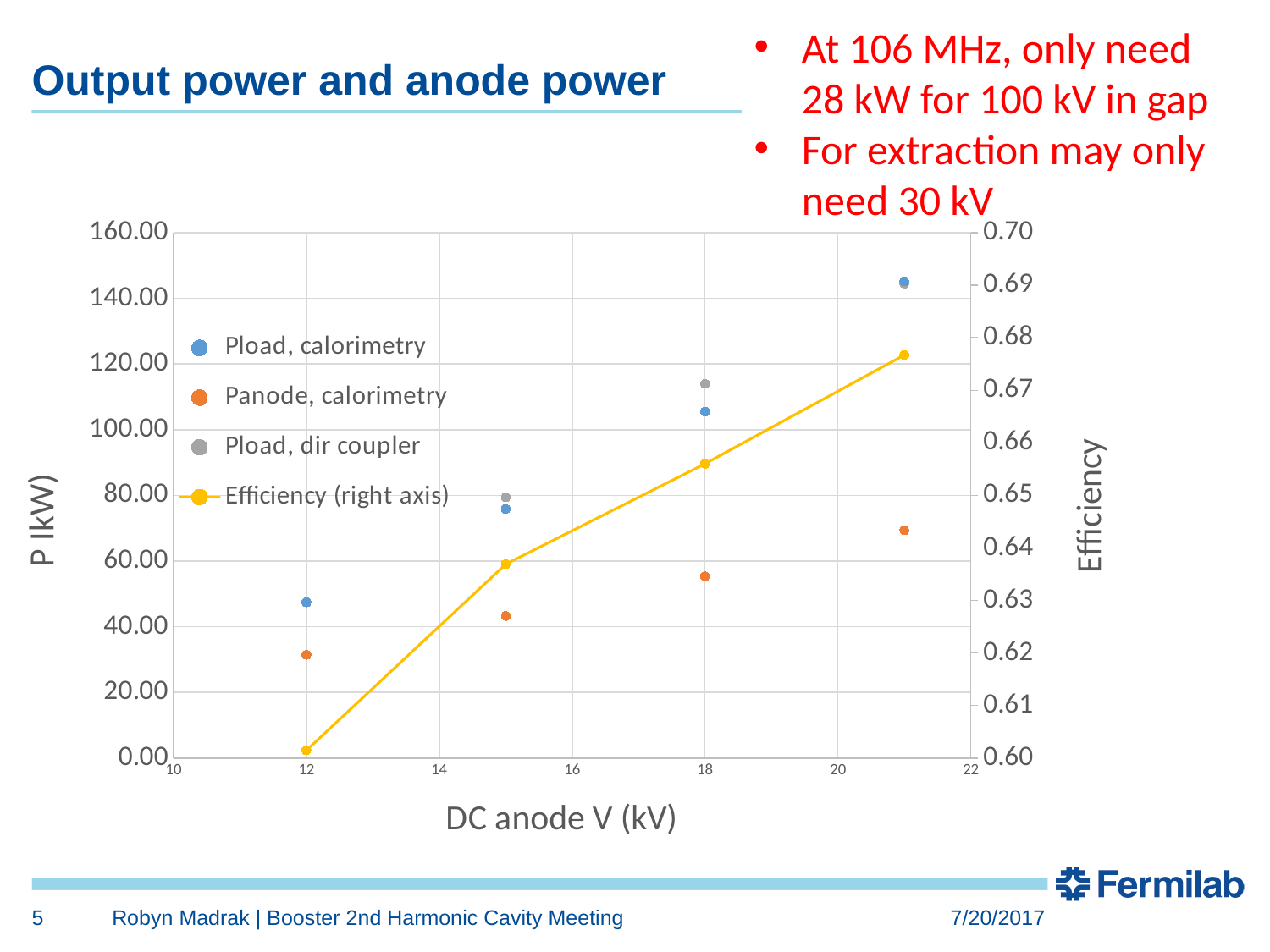
What kind of chart is shown on the slide? scatter chart How many data points are plotted for the Efficiency (right axis) series? 4 Is the value for Pload, dir coupler at 18 kV greater or less than 100? greater Is the Efficiency value at 18 kV greater or less than 0.65? greater At which DC anode V is the Efficiency value lowest? 12 At 18 kV, which is larger: Pload, calorimetry or Panode, calorimetry? Pload, calorimetry What is the title of the x axis of the chart? DC anode V (kV) Is the value for Pload, calorimetry at 21 kV greater or less than 140? greater Does the Efficiency (right axis) series rise or fall as DC anode V increases? rises At which DC anode V is the Pload, calorimetry value highest? 21 How many series does the chart legend list? 4